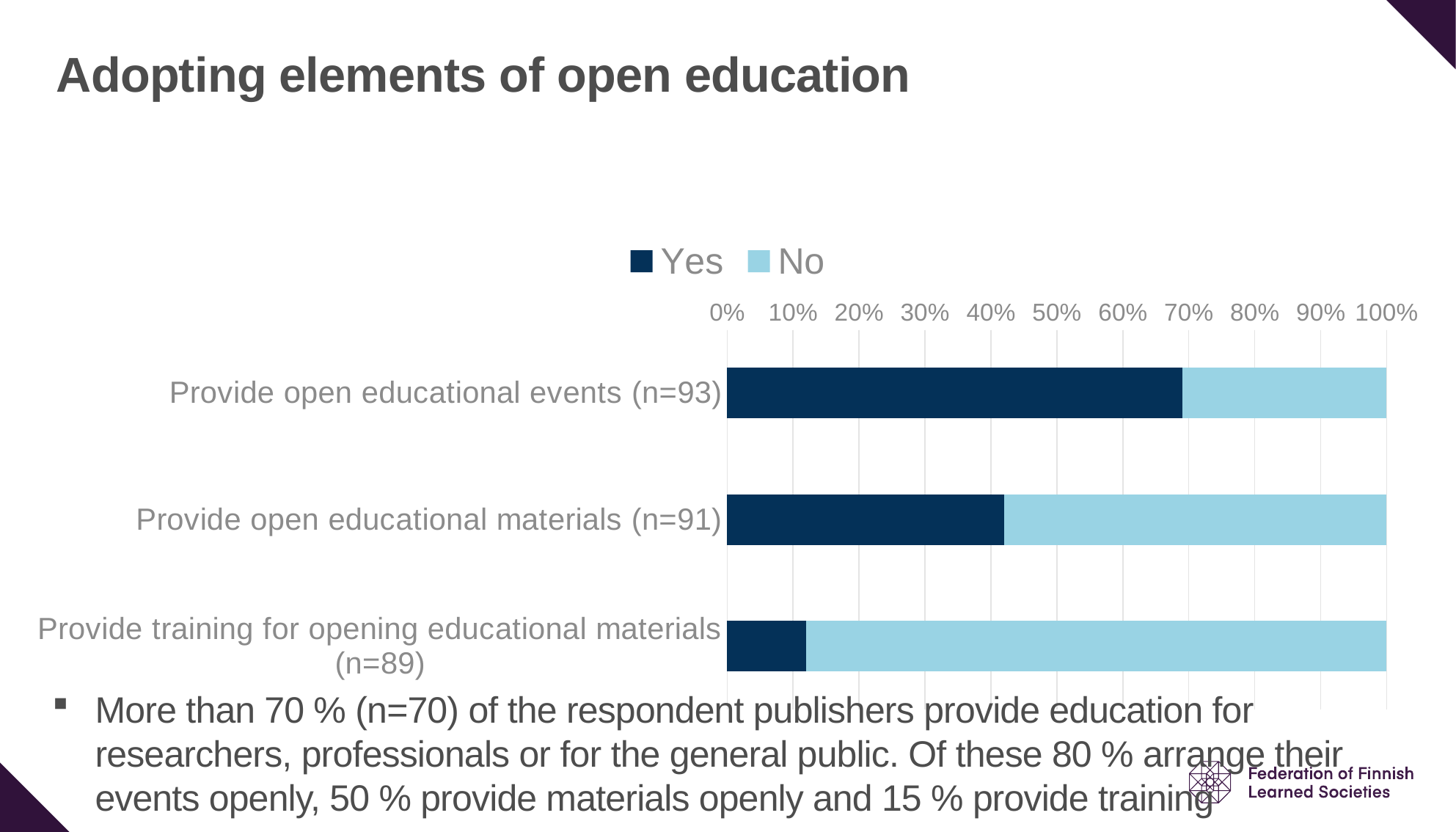
How many series does the legend list? 2 Which category has the lowest 'Yes' share? Provide training for opening educational materials (n=89) Which series is shown in dark navy in the chart? Yes Which is larger for 'Provide open educational events (n=93)': the 'Yes' share or the 'No' share? Yes Which category has the highest 'Yes' share? Provide open educational events (n=93) Is the 'Yes' value for 'Provide training for opening educational materials (n=89)' greater or less than 20%? less What kind of chart is shown on the slide? bar chart Which is larger for 'Provide open educational materials (n=91)': the 'Yes' share or the 'No' share? No Is the 'Yes' value for 'Provide open educational materials (n=91)' greater or less than 50%? less How many categories are plotted in the chart? 3 Is the 'Yes' value for 'Provide open educational events (n=93)' greater or less than 60%? greater